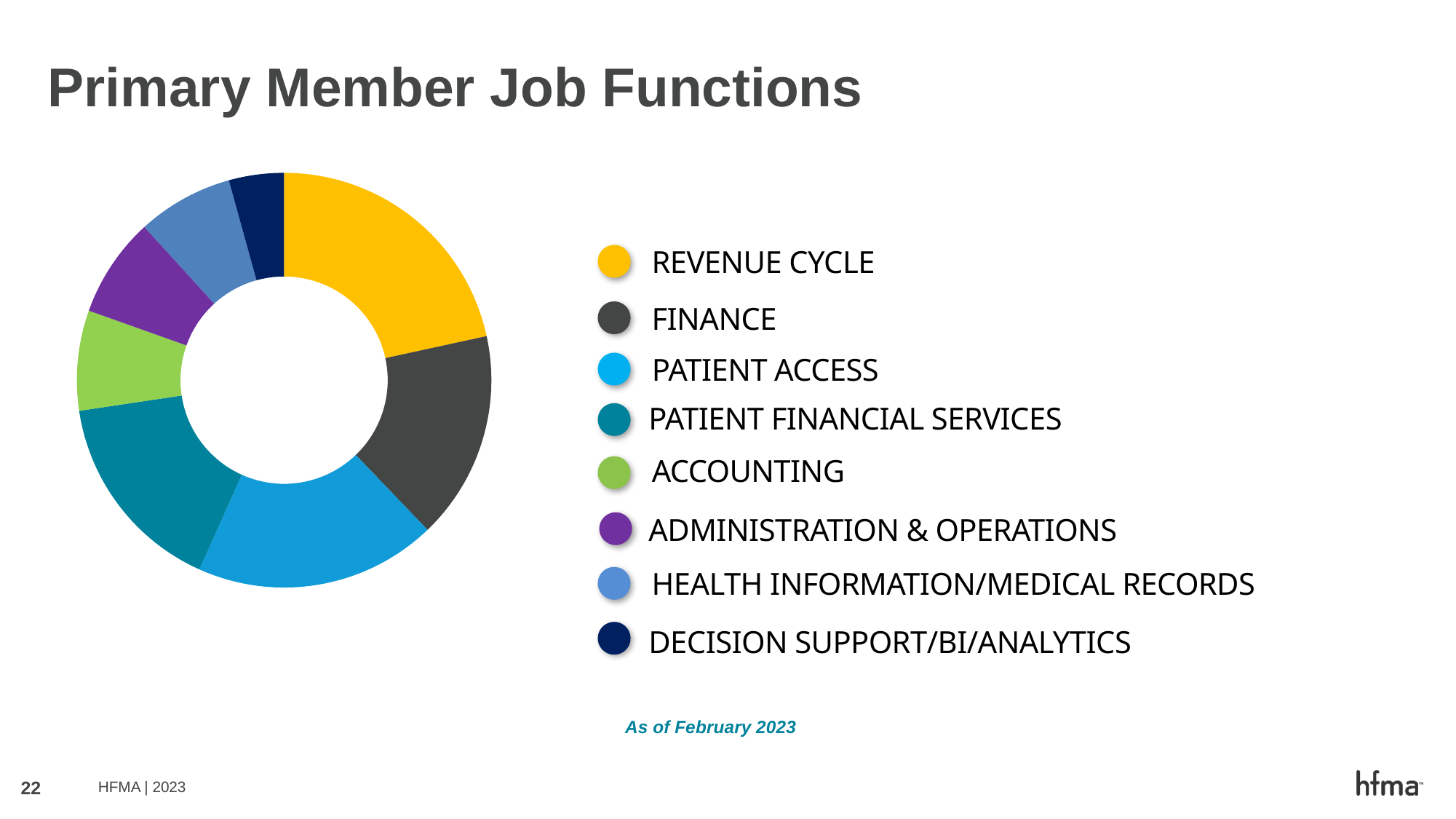
Which slice is larger, Patient Financial Services or Administration & Operations? Patient Financial Services What is the title of the chart on the slide? Primary Member Job Functions What kind of chart is shown on the slide? Pie chart (donut) Which job function has the largest slice of the chart? Revenue Cycle Which slice is larger, Patient Access or Health Information/Medical Records? Patient Access How many job function categories does the chart show? 8 Which job function has the smallest slice of the chart? Decision Support/BI/Analytics Which job function is represented by the yellow slice? Revenue Cycle Which slice is larger, Finance or Decision Support/BI/Analytics? Finance